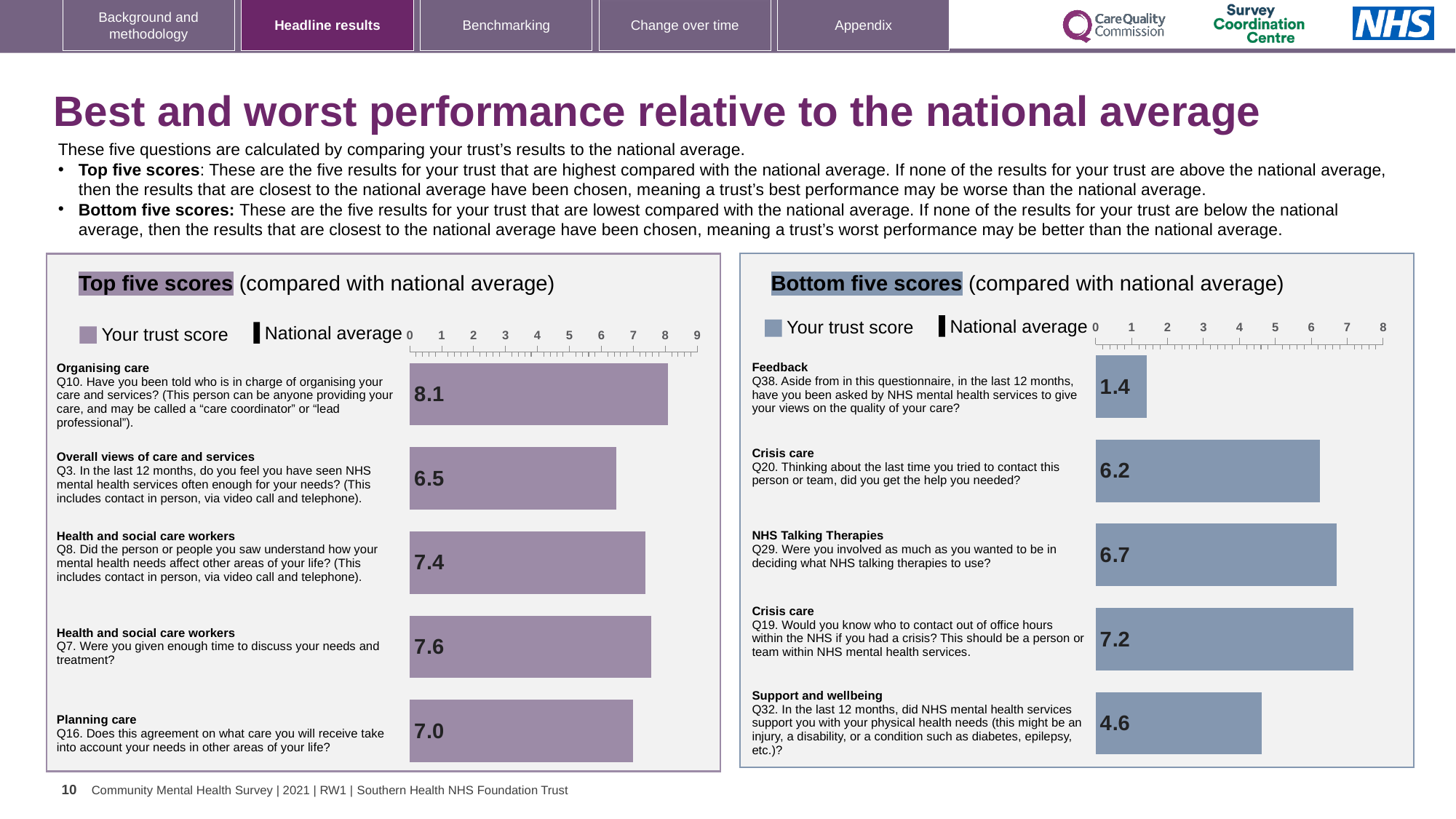
In the Bottom five scores chart, which has the larger trust score, Q29 or Q20? Q29 How many entries does the legend of the Top five scores chart list? 2 In the Top five scores chart, what is the trust score for Q10 (Organising care)? 8.1 In the Bottom five scores chart, which question has the lowest trust score? Q38 (Feedback) How many bars are plotted in the Top five scores chart? 5 In the Top five scores chart, which question has the highest trust score? Q10 (Organising care) In the Bottom five scores chart, is the trust score for Q19 greater or less than 6? greater In the Bottom five scores chart, what is the trust score for Q32 (Support and wellbeing)? 4.6 In the Bottom five scores chart, what is the difference between the trust scores for Q19 and Q38? 5.8 What type of chart is the Bottom five scores chart? Bar chart In the Top five scores chart, what is the trust score for Q7 (Health and social care workers)? 7.6 In the Top five scores chart, what is the difference between the trust scores for Q10 and Q3? 1.6